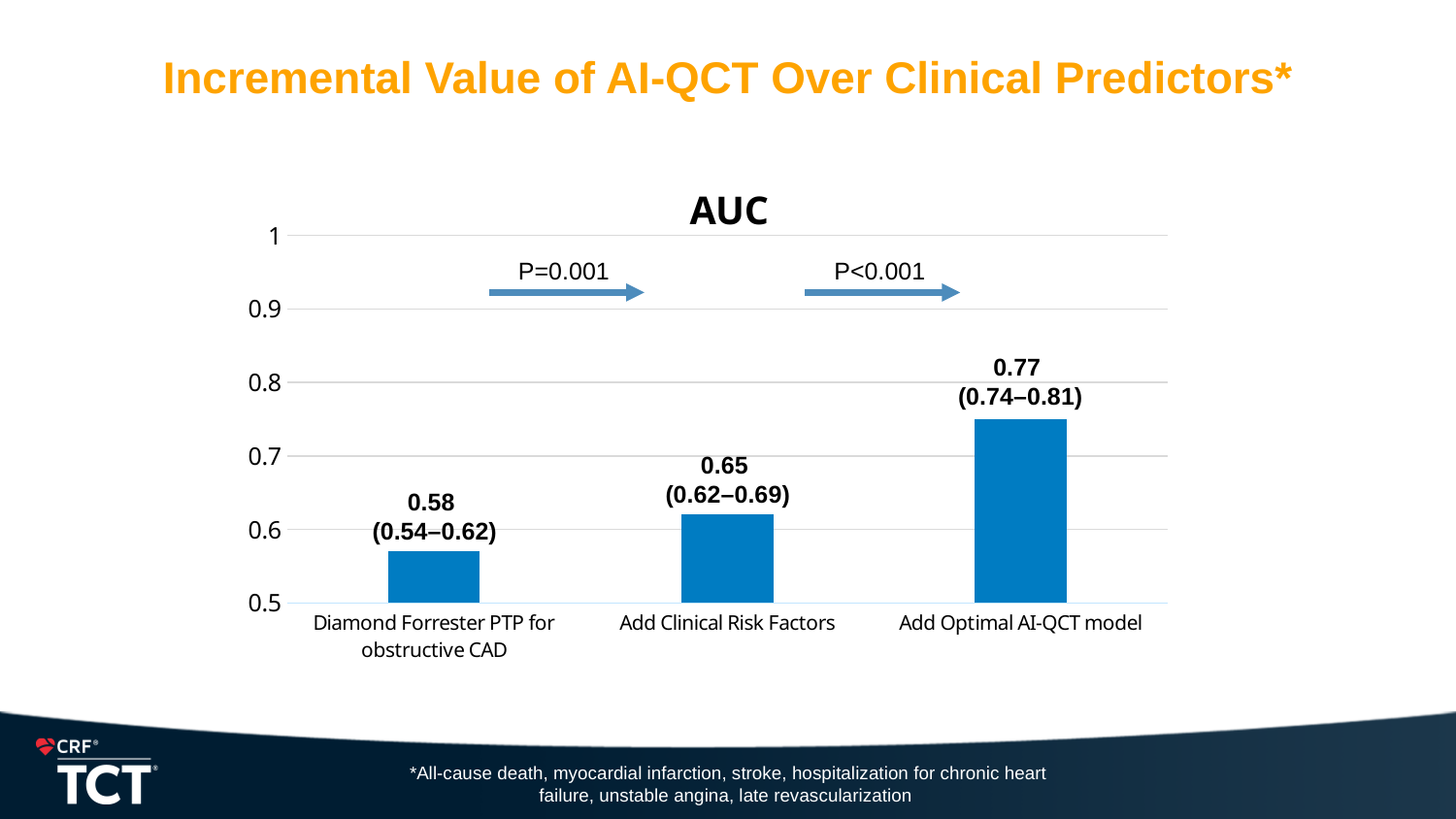
What is the AUC value for Diamond Forrester PTP for obstructive CAD? 0.58 Which category has the lowest AUC? Diamond Forrester PTP for obstructive CAD What kind of chart is shown on the slide? bar chart Which category has the highest AUC? Add Optimal AI-QCT model Is the AUC for Add Clinical Risk Factors greater or less than 0.7? less What is the AUC value for Add Optimal AI-QCT model? 0.77 Which has a higher AUC, Add Clinical Risk Factors or Add Optimal AI-QCT model? Add Optimal AI-QCT model What is the difference in AUC between Add Optimal AI-QCT model and Diamond Forrester PTP for obstructive CAD? 0.19 What is the difference in AUC between Add Clinical Risk Factors and Diamond Forrester PTP for obstructive CAD? 0.07 What is the AUC value for Add Clinical Risk Factors? 0.65 How many categories are shown in the chart? 3 What is the confidence interval shown for Add Optimal AI-QCT model? (0.74–0.81)